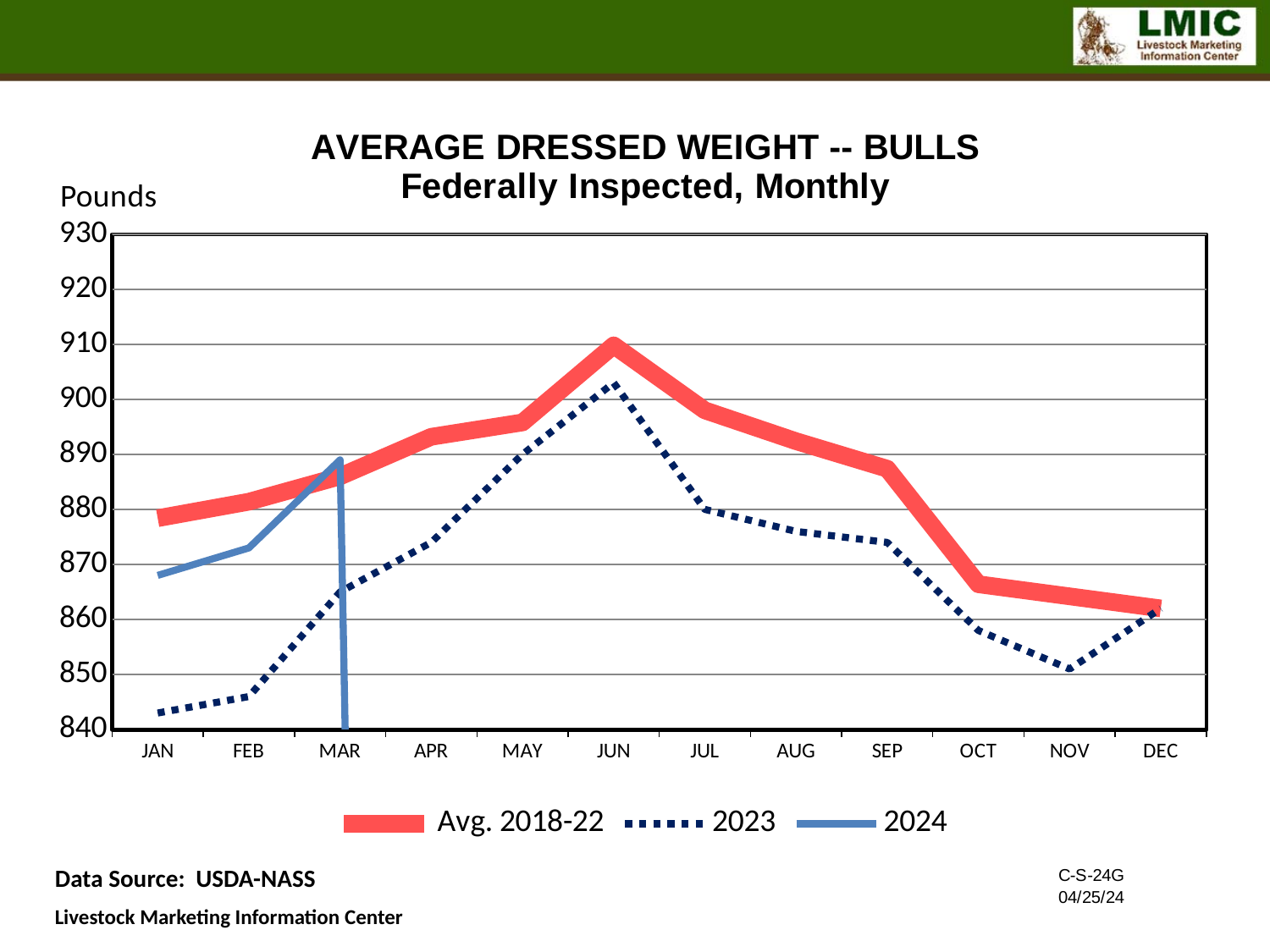
Is the Avg. 2018-22 value for OCT greater or less than 860? greater In which month does the Avg. 2018-22 series peak? JUN What kind of chart is shown on the slide? line chart In which month does the 2023 series reach its highest value? JUN How many series does the legend list? 3 What unit is shown on the y axis label? Pounds Is the 2023 value for JAN greater or less than 850? less In JAN, which series has the larger value, Avg. 2018-22 or 2023? Avg. 2018-22 How many months are shown along the x axis? 12 In which month is the 2023 series at its lowest value? JAN Does the 2023 series rise or fall from JAN to JUN? rise